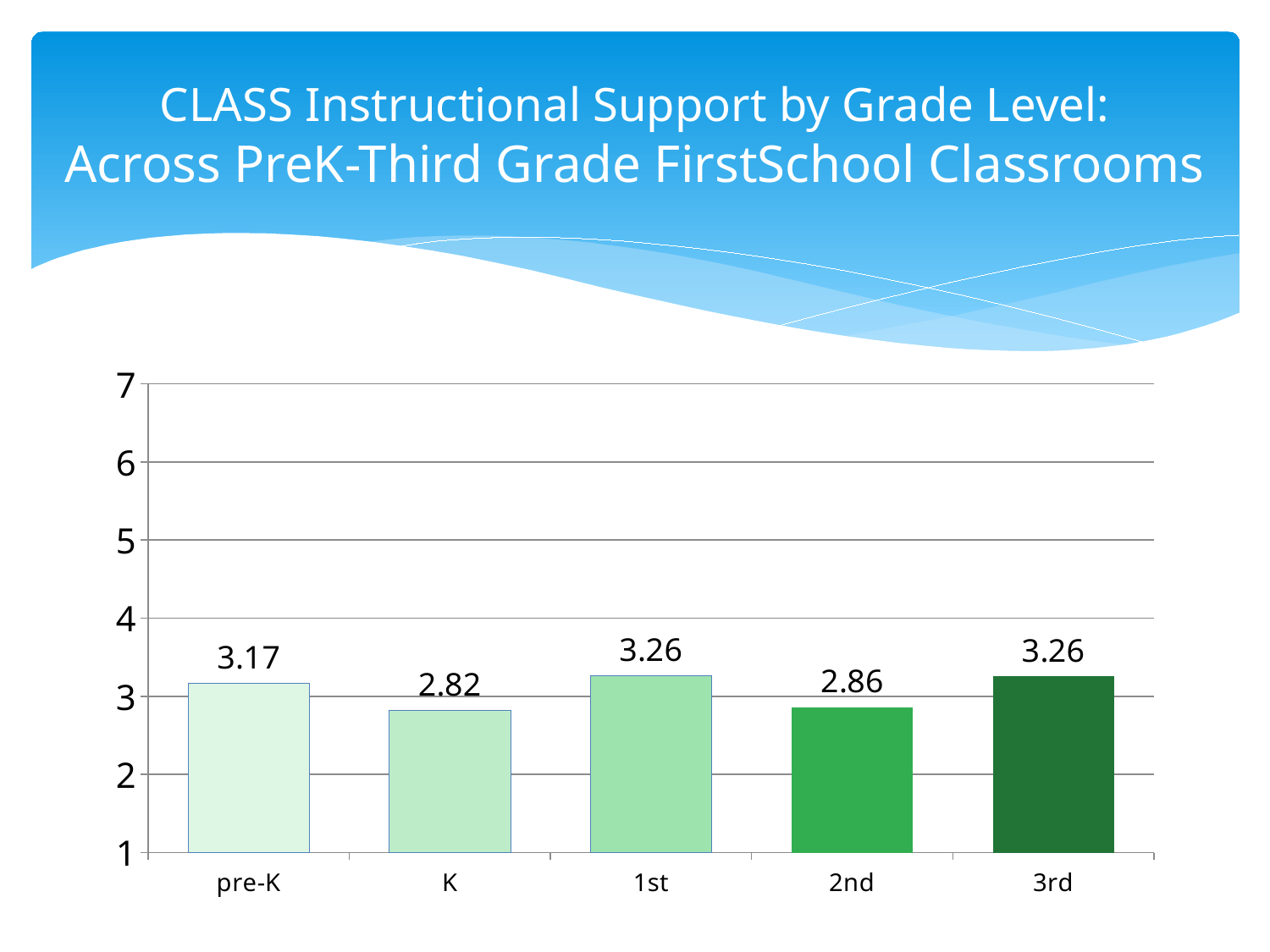
Which grade level has the lowest value? K What is the CLASS Instructional Support value for pre-K? 3.17 How many grade levels are shown on the x axis? 5 Which is larger, the value for pre-K or the value for K? pre-K What is the value shown for 2nd grade? 2.86 What is the difference between the values for pre-K and 2nd grade? 0.31 What kind of chart is shown on the slide? bar chart What is the difference between the values for 1st grade and K? 0.44 Is the value for 3rd grade greater or less than 4? less What is the value shown for K (kindergarten)? 2.82 What is the title of the slide? CLASS Instructional Support by Grade Level: Across PreK-Third Grade FirstSchool Classrooms What is the value shown for 3rd grade? 3.26